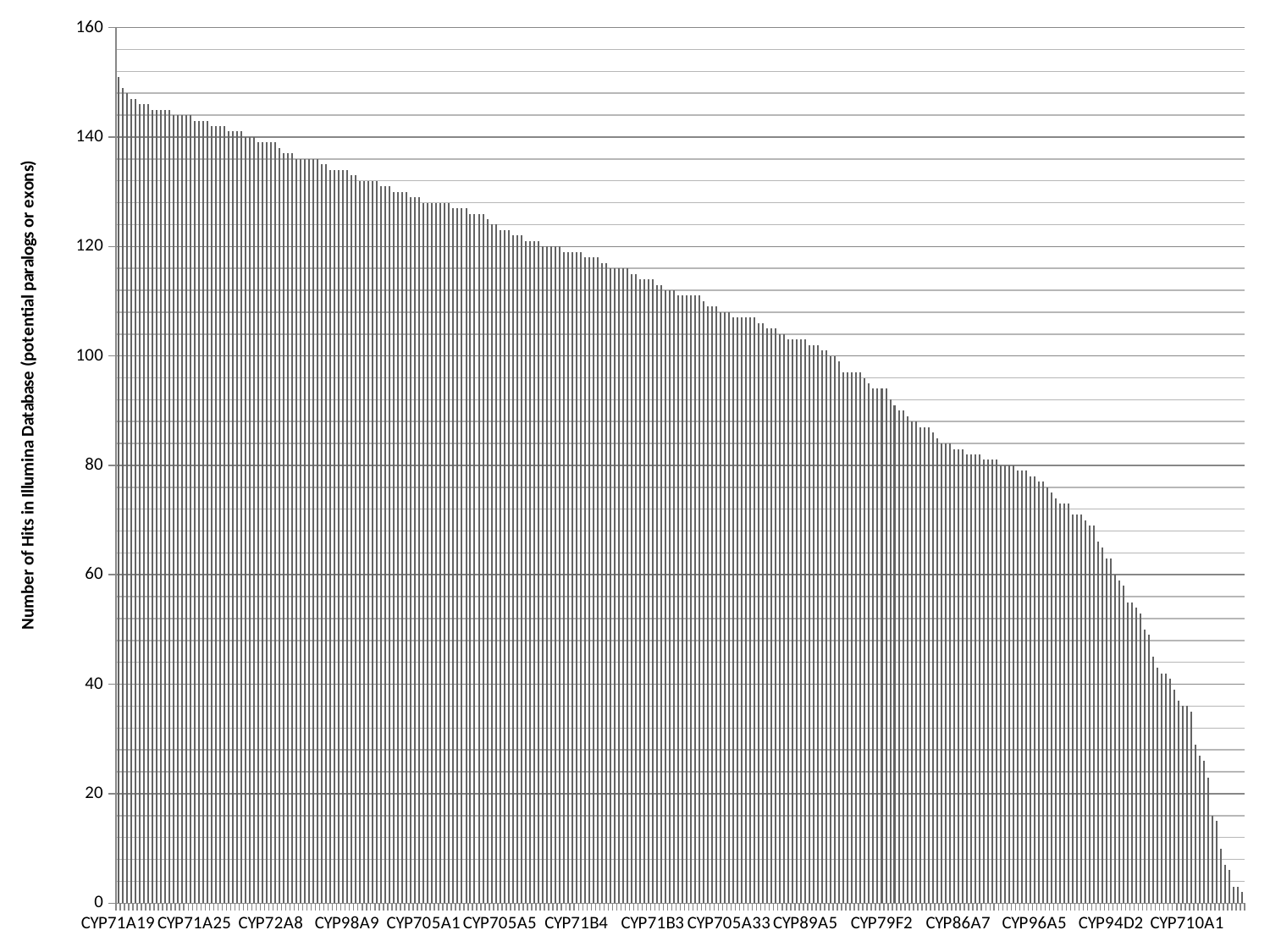
What kind of chart is shown on the slide? bar chart Is the value for CYP705A1 greater or less than 140? less Do the values rise or fall moving from left to right along the x axis? fall What is the title of the vertical axis? Number of Hits in Illumina Database (potential paralogs or exons) Is the value for CYP98A9 greater or less than 120? greater Which has the larger value, CYP71A25 or CYP94D2? CYP71A25 Is the value for CYP71B3 greater or less than 100? greater Which labelled category has the highest number of hits? CYP71A19